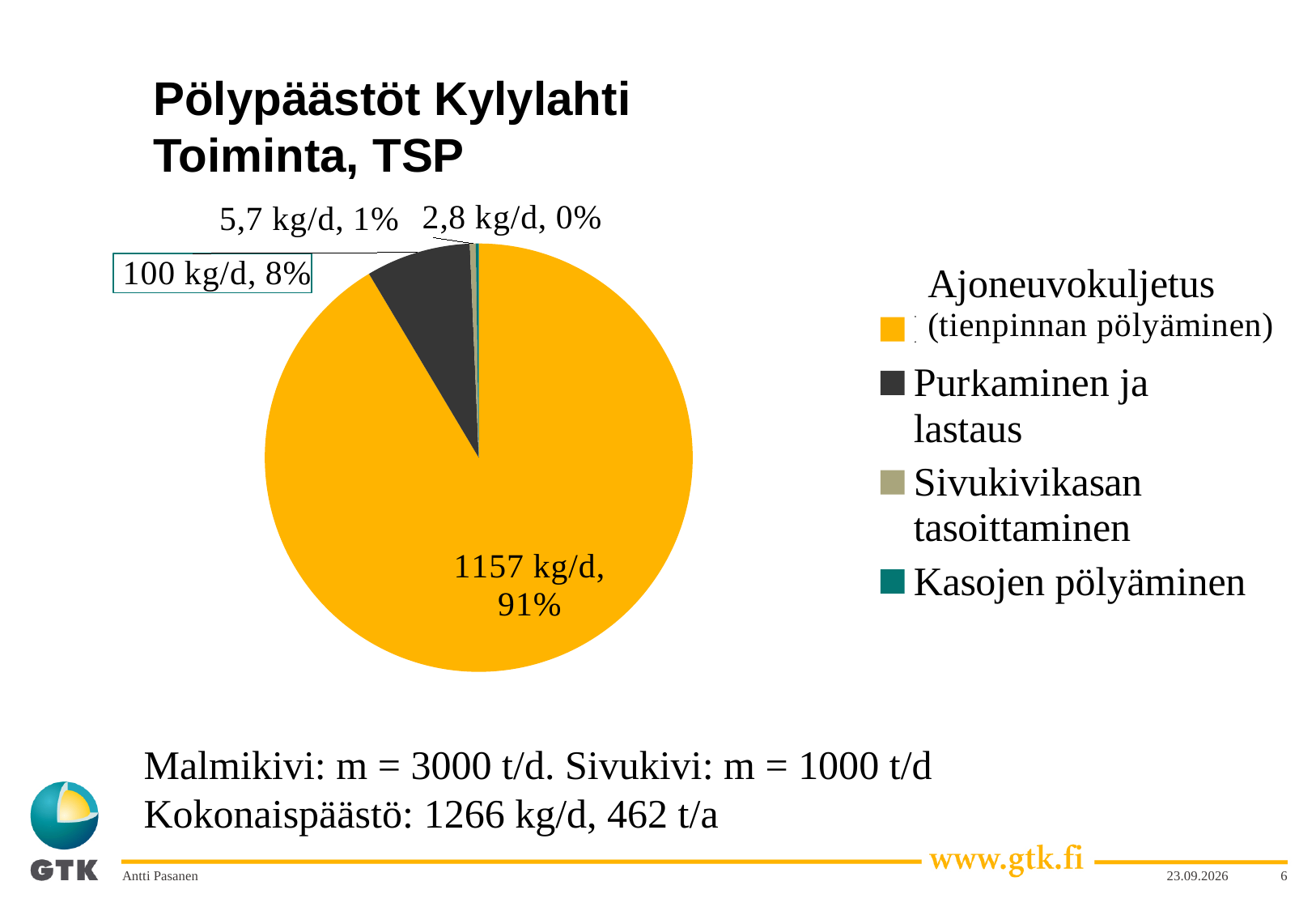
What share of the pie does Ajoneuvokuljetus (tienpinnan pölyäminen) represent? 91% What type of chart is shown on the slide? pie chart How many categories does the legend list? 4 What is the value for Sivukivikasan tasoittaminen? 5,7 kg/d What share of the pie does Purkaminen ja lastaus represent? 8% Which category has the largest slice of the pie? Ajoneuvokuljetus (tienpinnan pölyäminen) What is the value for Kasojen pölyäminen? 2,8 kg/d Which category has the smallest slice of the pie? Kasojen pölyäminen What is the value for Ajoneuvokuljetus (tienpinnan pölyäminen)? 1157 kg/d What is the value for Purkaminen ja lastaus? 100 kg/d What colour is the slice for Purkaminen ja lastaus? dark grey What is the difference between the values for Ajoneuvokuljetus (tienpinnan pölyäminen) and Purkaminen ja lastaus? 1057 kg/d